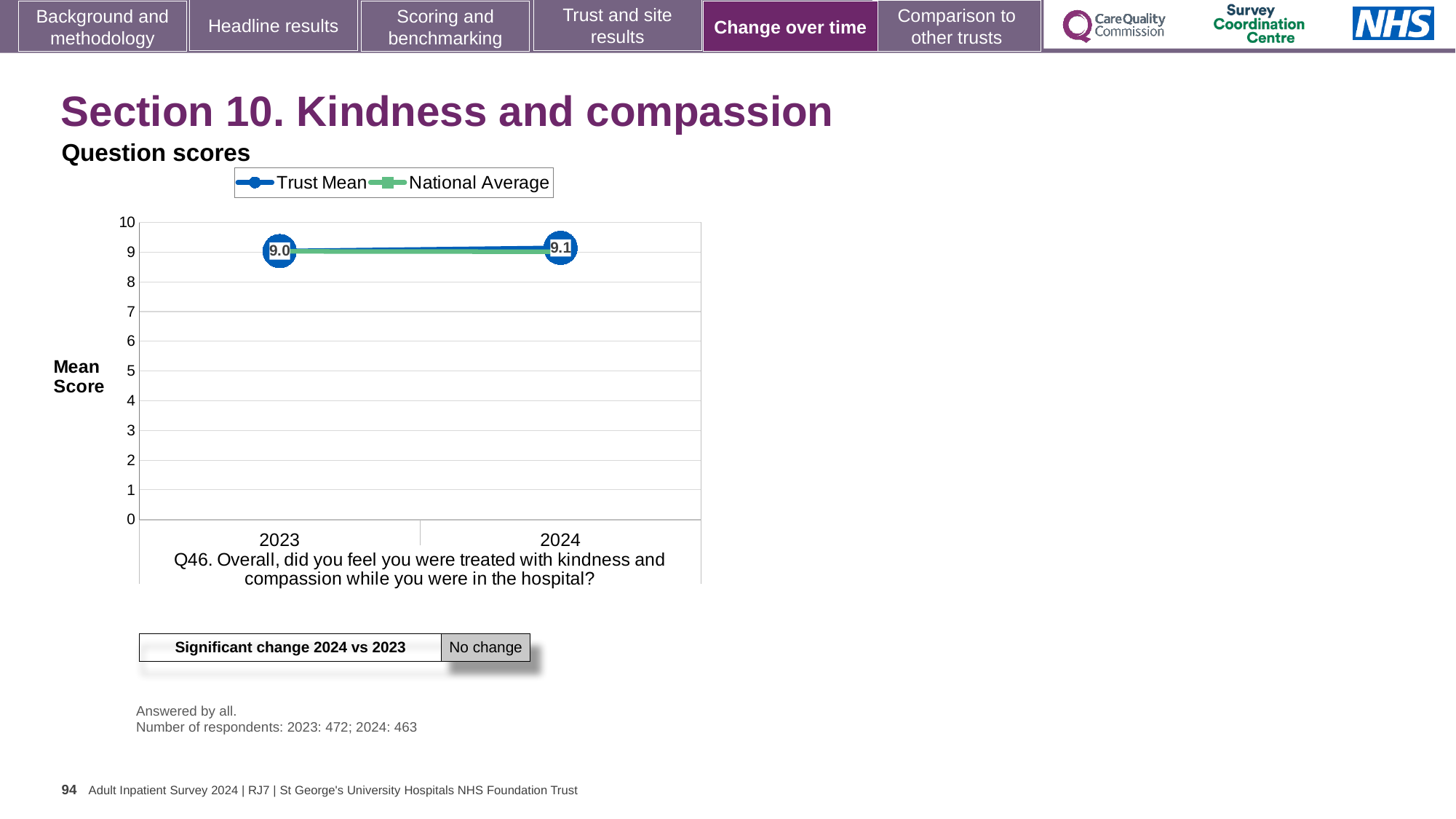
What are the two series named in the chart legend? Trust Mean and National Average What is the Trust Mean score for 2024? 9.1 What is the label on the y axis of the chart? Mean Score Is the Trust Mean value for 2024 greater or less than 8? greater How many series does the legend list? 2 What is the Trust Mean score for 2023? 9.0 Is the National Average value for 2023 greater or less than 5? greater How many years are plotted on the x axis? 2 Which year has the higher Trust Mean score, 2023 or 2024? 2024 By how much did the Trust Mean change from 2023 to 2024? 0.1 Does the Trust Mean rise or fall from 2023 to 2024? rise What kind of chart is shown on the slide? line chart